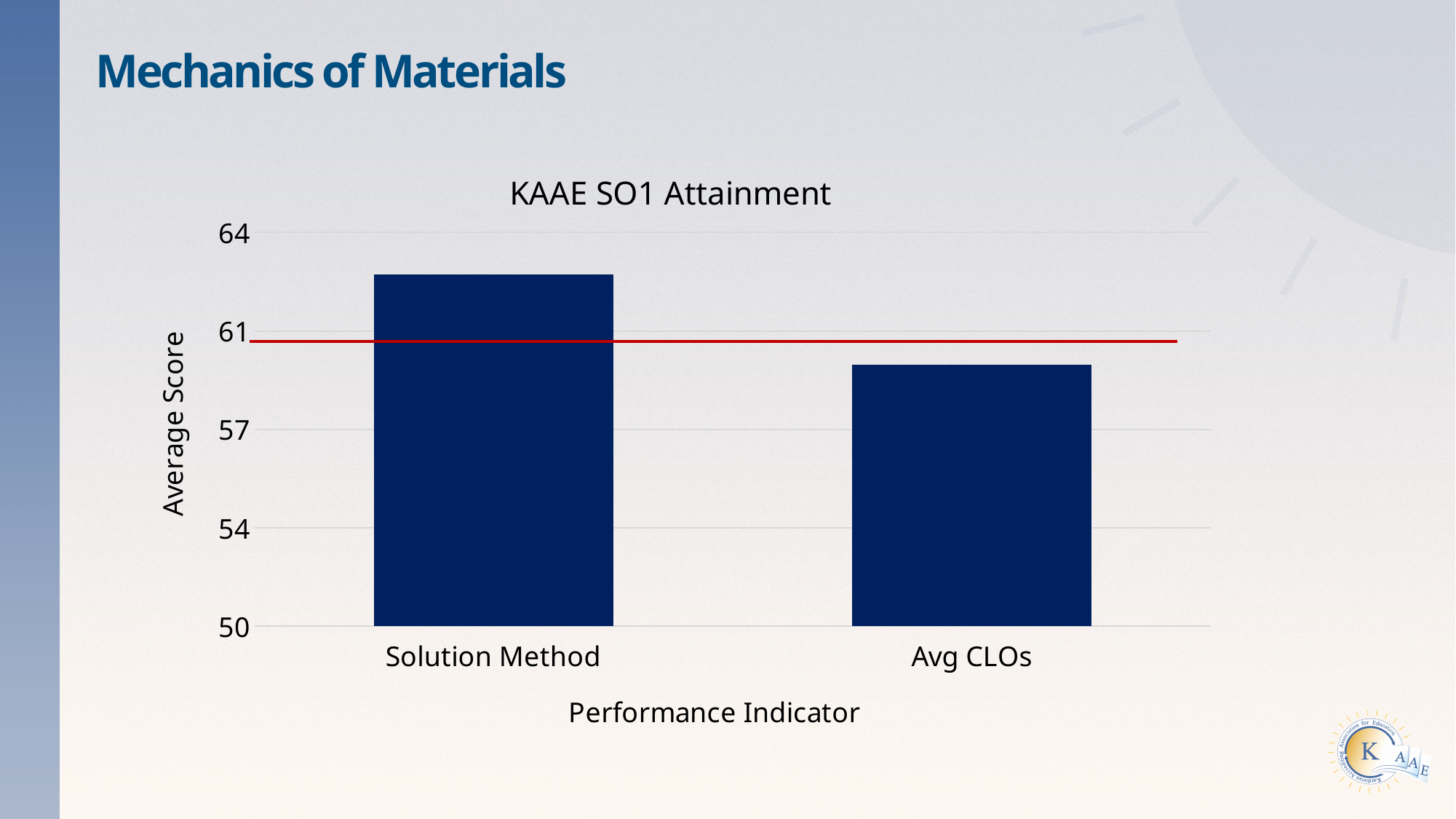
What kind of chart is shown on the slide? bar chart What is the title of the chart? KAAE SO1 Attainment Is the value for Solution Method greater or less than 61? greater Is the value for Solution Method greater or less than 64? less Is the value for Avg CLOs greater or less than 61? less Which category has the highest average score? Solution Method Which category has the lowest average score? Avg CLOs What is the label of the y axis of the chart? Average Score Which is larger, the value for Solution Method or the value for Avg CLOs? Solution Method How many categories are plotted on the x axis of the chart? 2